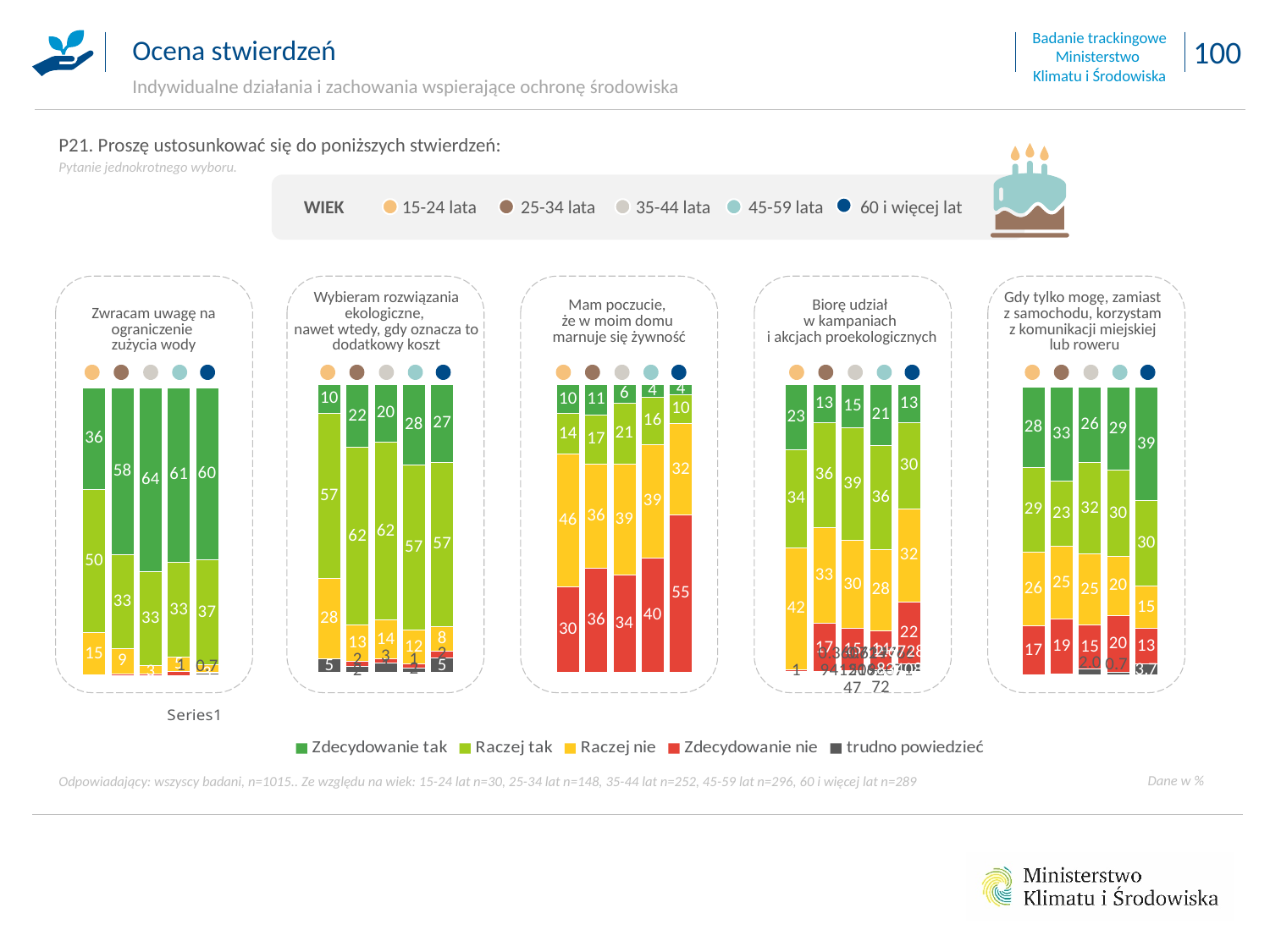
In the chart 'Wybieram rozwiązania ekologiczne, nawet wtedy, gdy oznacza to dodatkowy koszt', which age group has the lowest 'Zdecydowanie tak' value? 15-24 lata In the chart 'Mam poczucie, że w moim domu marnuje się żywność', which is larger: the 'Raczej nie' value for 15-24 lata or for 25-34 lata? 15-24 lata In the chart 'Mam poczucie, że w moim domu marnuje się żywność', what is the 'Zdecydowanie nie' value for the 60 i więcej lat group? 55 How many series does the legend at the bottom of the slide list? 5 In the chart 'Gdy tylko mogę, zamiast z samochodu, korzystam z komunikacji miejskiej lub roweru', what is the 'Zdecydowanie nie' value for the 25-34 lata group? 19 In the chart 'Gdy tylko mogę, zamiast z samochodu, korzystam z komunikacji miejskiej lub roweru', which age group has the highest 'Zdecydowanie tak' value? 60 i więcej lat In the chart 'Mam poczucie, że w moim domu marnuje się żywność', what is the difference between the 'Zdecydowanie nie' values for 60 i więcej lat and 15-24 lata? 25 In the chart 'Wybieram rozwiązania ekologiczne, nawet wtedy, gdy oznacza to dodatkowy koszt', what is the 'Raczej nie' value for the 15-24 lata group? 28 What kind of chart is used for 'Biorę udział w kampaniach i akcjach proekologicznych'? Stacked bar chart In the chart 'Biorę udział w kampaniach i akcjach proekologicznych', what is the 'Raczej nie' value for the 15-24 lata group? 42 In the chart 'Zwracam uwagę na ograniczenie zużycia wody', which age group has the highest 'Zdecydowanie tak' value? 35-44 lata In the chart 'Zwracam uwagę na ograniczenie zużycia wody', what is the 'Zdecydowanie tak' value for the 15-24 lata group? 36